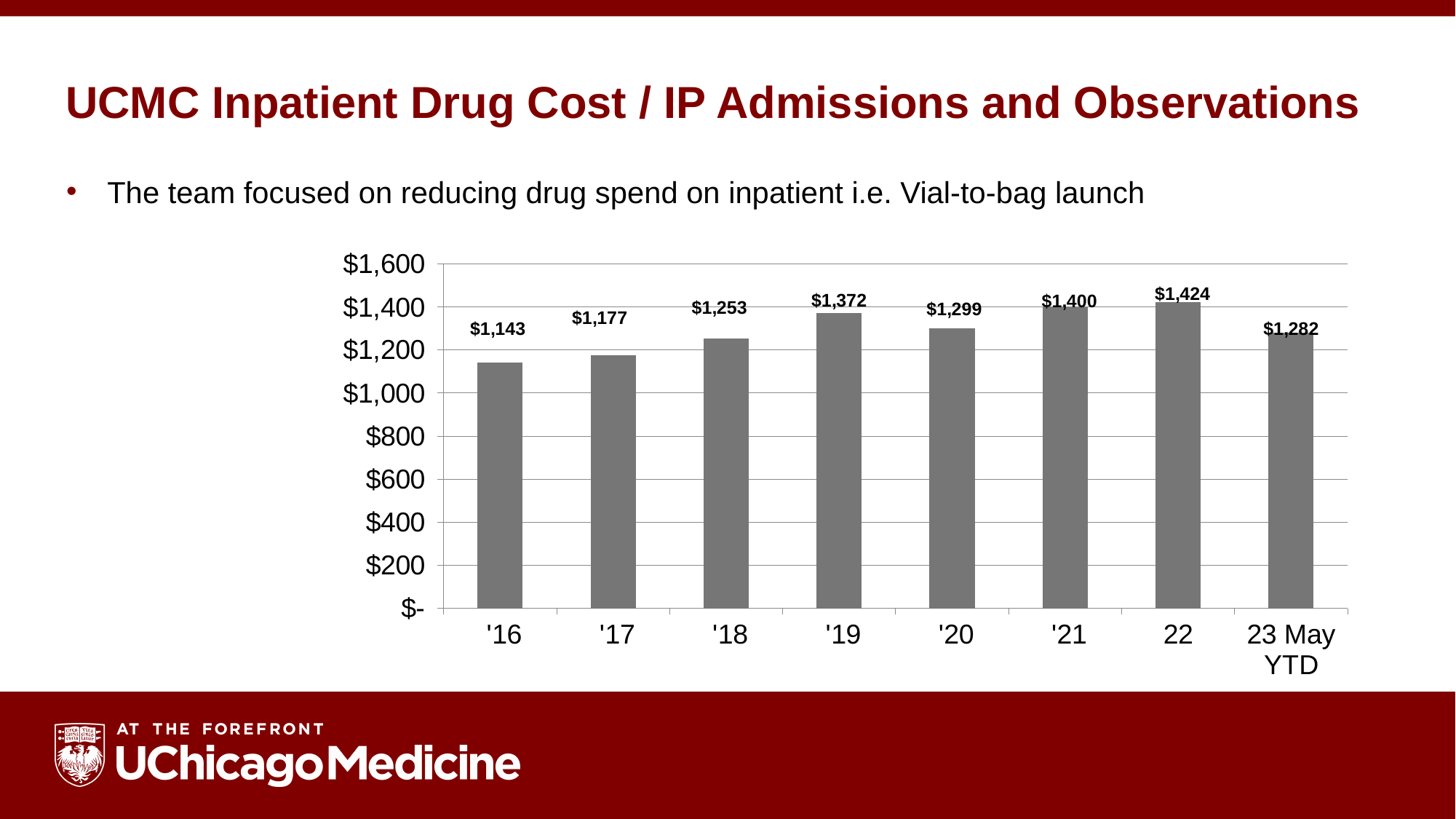
Which category has the lowest value? '16 What is the difference between the values for '19 and '20? $73 Is the value for '18 greater or less than $1,200? greater What is the value for '16? $1,143 What is the value for '19? $1,372 Which is larger, the value for '21 or the value for 23 May YTD? '21 What is the value for 23 May YTD? $1,282 Which category has the highest value? 22 How many categories are shown on the x axis? 8 Do the values rise or fall from '16 to '19? rise What kind of chart is shown on the slide? bar chart What is the difference between the values for 22 and '16? $281